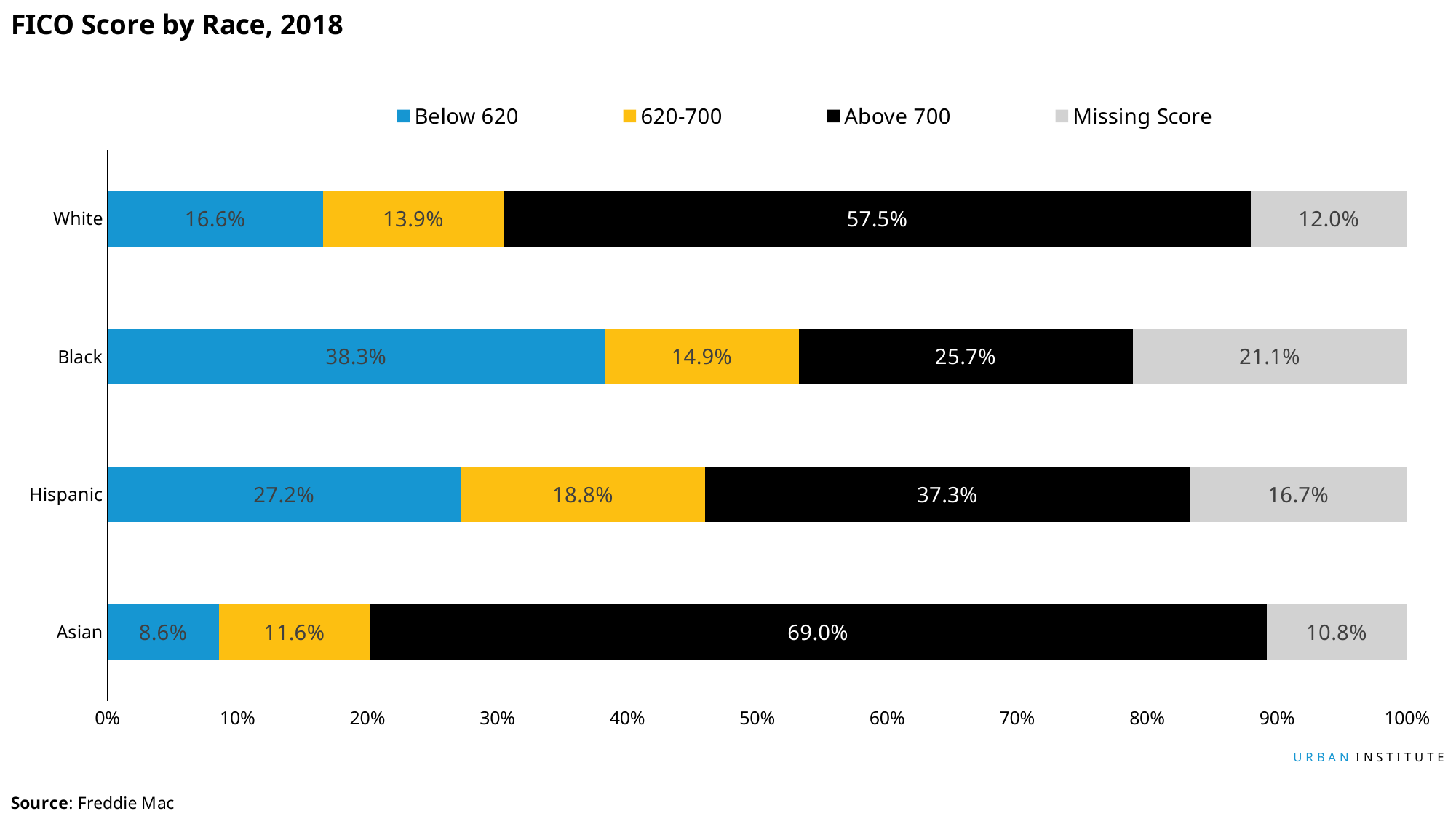
What is the difference between the Above 700 share for Asian borrowers and for Black borrowers? 43.3 percentage points Which race has the highest Missing Score share? Black How many race categories are shown in the chart? 4 Which race has the lowest share of borrowers with a FICO score below 620? Asian What percentage of Black borrowers have a FICO score below 620? 38.3% What kind of chart is shown on the slide? Stacked bar chart How many series does the legend list? 4 What is the Missing Score share for Hispanic borrowers? 16.7% Which is larger: the Below 620 share for Hispanic borrowers or for White borrowers? Hispanic What percentage of White borrowers have a FICO score above 700? 57.5% Which race has the highest share of borrowers with a FICO score above 700? Asian What percentage of Asian borrowers have a FICO score in the 620-700 range? 11.6%